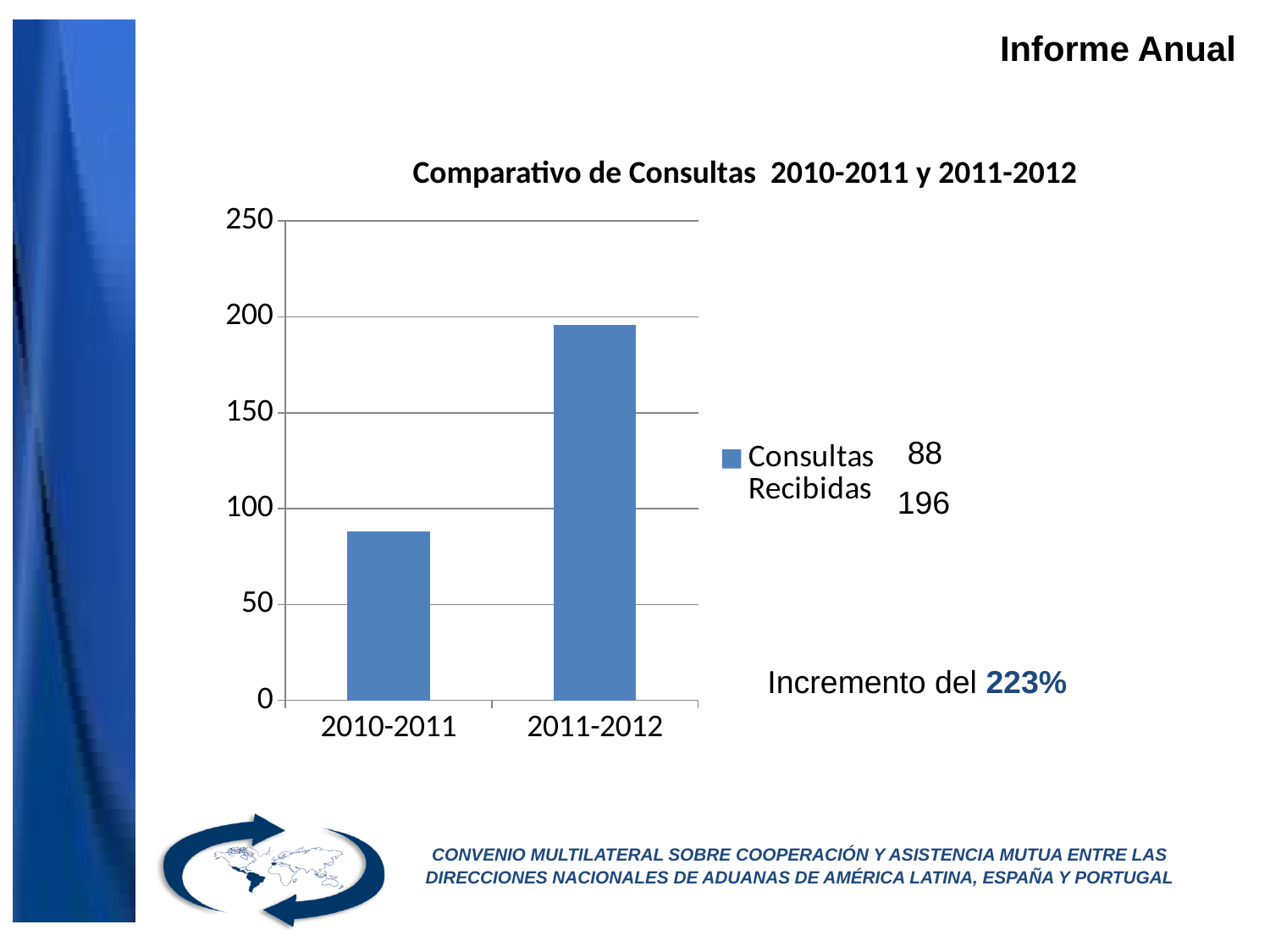
Which period has the highest number of Consultas Recibidas? 2011-2012 What is the value of Consultas Recibidas for 2010-2011? 88 What kind of chart is shown on the slide? bar chart Do the values rise or fall from 2010-2011 to 2011-2012? rise What series name appears in the legend? Consultas Recibidas Is the value for 2010-2011 greater or less than 100? less What is the difference between the values for 2011-2012 and 2010-2011? 108 What is the title of the chart? Comparativo de Consultas 2010-2011 y 2011-2012 What is the value of Consultas Recibidas for 2011-2012? 196 How many categories are shown on the x axis of the chart? 2 How many series does the legend list? 1 Which period has the lowest number of Consultas Recibidas? 2010-2011